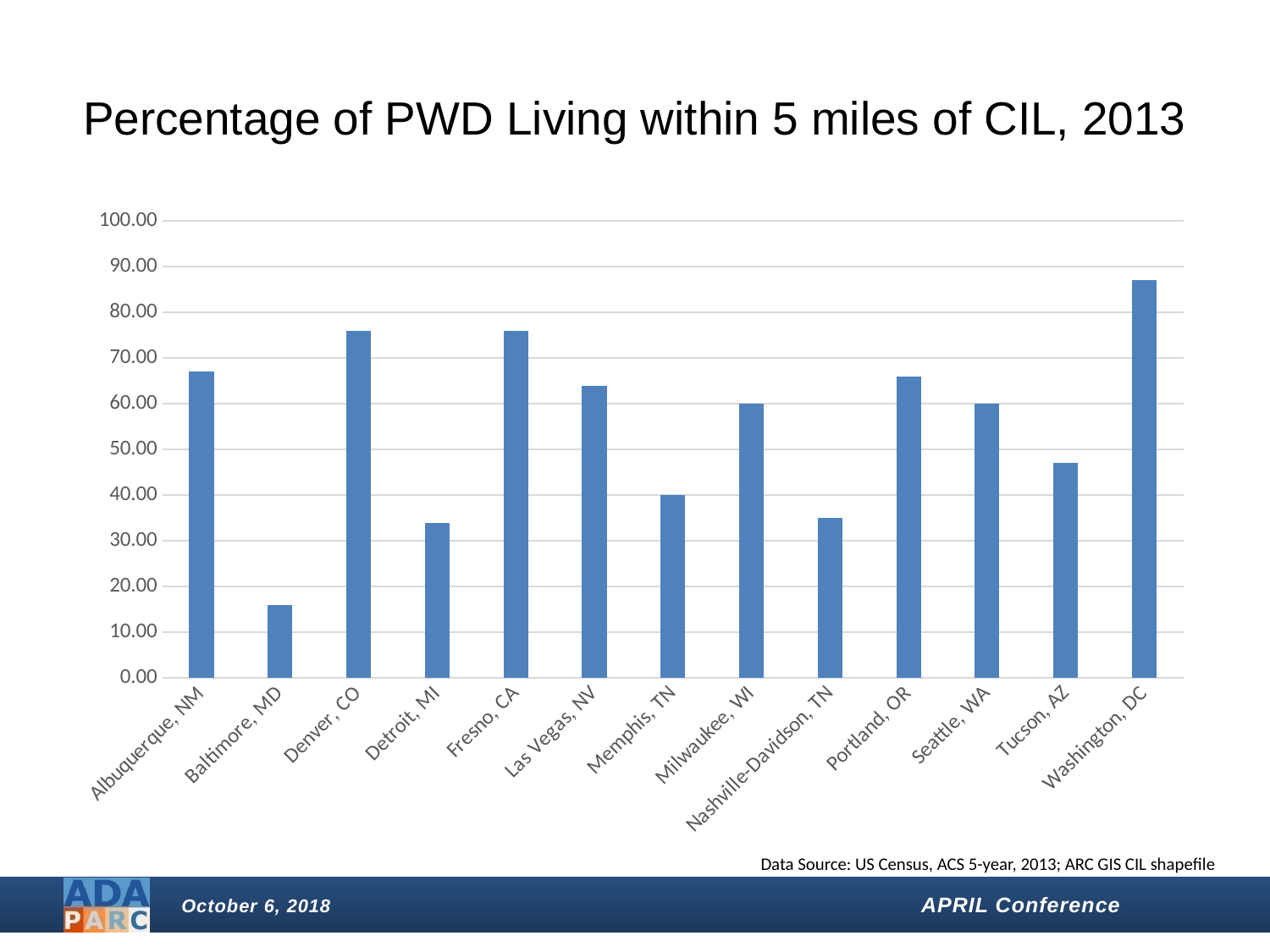
What is the title of the chart on the slide? Percentage of PWD Living within 5 miles of CIL, 2013 Is the value for Nashville-Davidson, TN greater or less than 40.00? less Which has a higher value, Denver, CO or Detroit, MI? Denver, CO Which city has the lowest percentage of PWD living within 5 miles of a CIL? Baltimore, MD Which city has the highest percentage of PWD living within 5 miles of a CIL? Washington, DC How many cities are shown on the x axis of the chart? 13 Which has a higher value, Albuquerque, NM or Tucson, AZ? Albuquerque, NM Is the value for Tucson, AZ greater or less than 50.00? less Is the value for Denver, CO greater or less than 70.00? greater What kind of chart is shown on the slide? bar chart